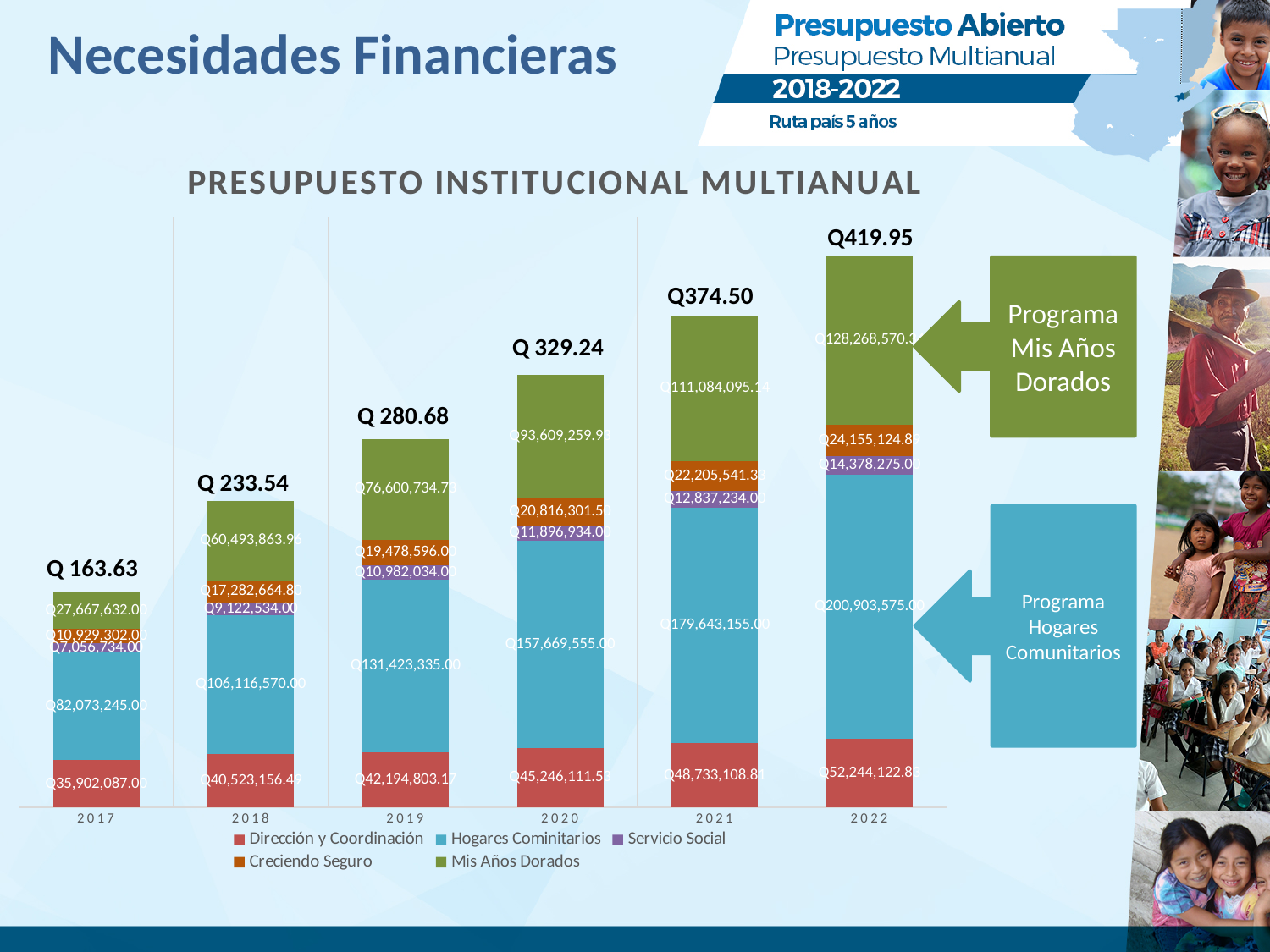
What is the total value labeled above the 2017 bar? Q 163.63 Which year has the lowest total budget? 2017 Which year has the highest total budget? 2022 Is the total for 2021 larger or smaller than the total for 2019? larger How many years are shown on the x axis? 6 How many series does the legend list? 5 What is the difference between the total labeled for 2022 and the total labeled for 2017? Q256.32 What kind of chart is shown on the slide? stacked bar chart Do the total budget values rise or fall from 2017 to 2022? rise What is the value of the Hogares Comunitarios segment for 2020? Q157,669,555.00 What is the total value labeled above the 2022 bar? Q419.95 What is the total value labeled above the 2020 bar? Q 329.24